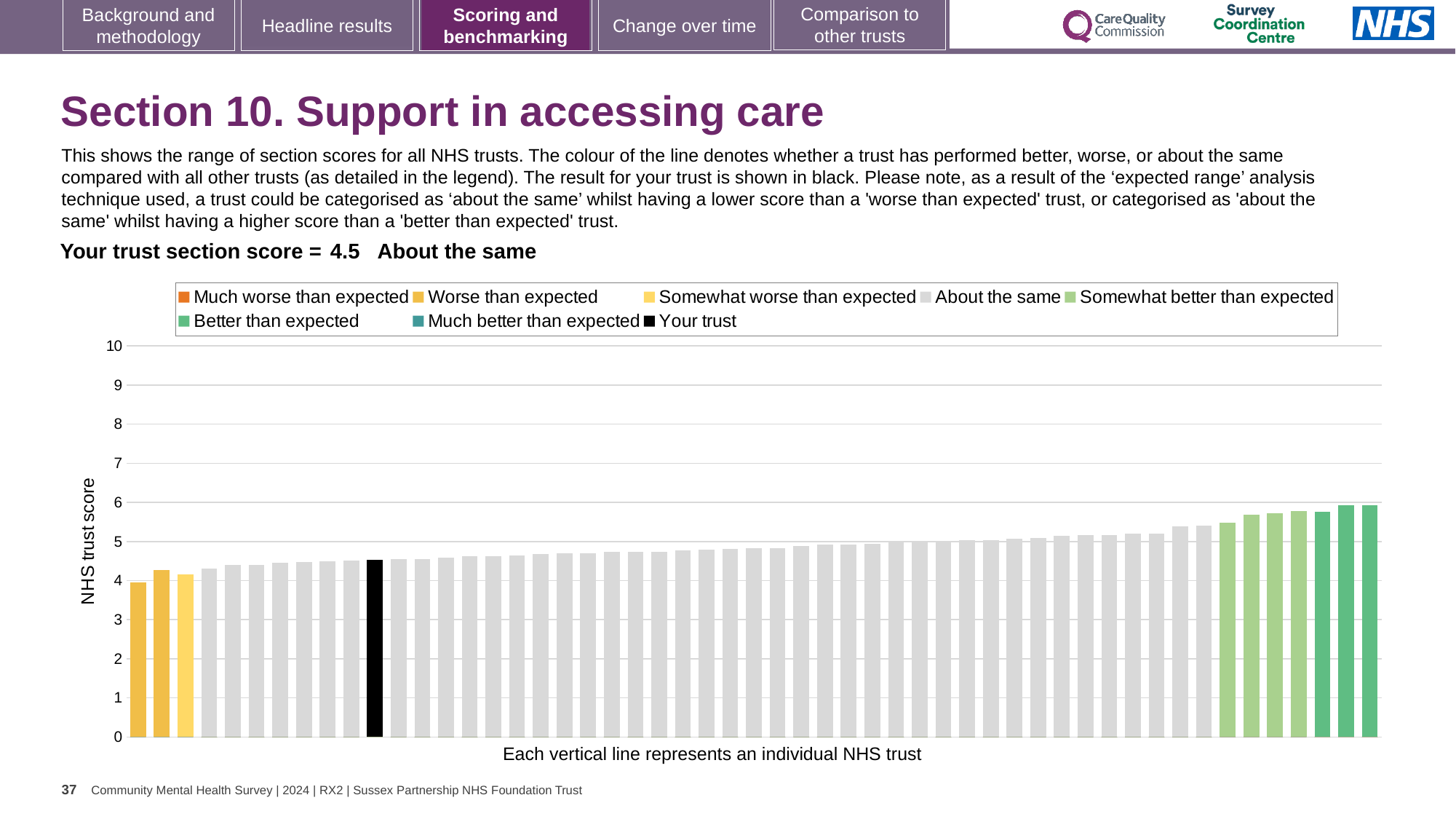
What is the section score for your trust shown on the slide? 4.5 How is your trust's section score categorised compared with other trusts? About the same What kind of chart is shown on the slide? Bar chart How many entries does the chart legend list? 8 What is the label on the y axis of the chart? NHS trust score Is the value of the shortest bar greater or less than 5? less What is the highest value shown on the y axis of the chart? 10 How many bars are coloured as 'Worse than expected' (yellow) in the chart? 2 What colour is used for the bar representing your trust? Black Is the value of the black bar (your trust) greater or less than 5? less Is the value of the tallest bar greater or less than 5? greater Do the bar values rise or fall from left to right along the x axis? Rise